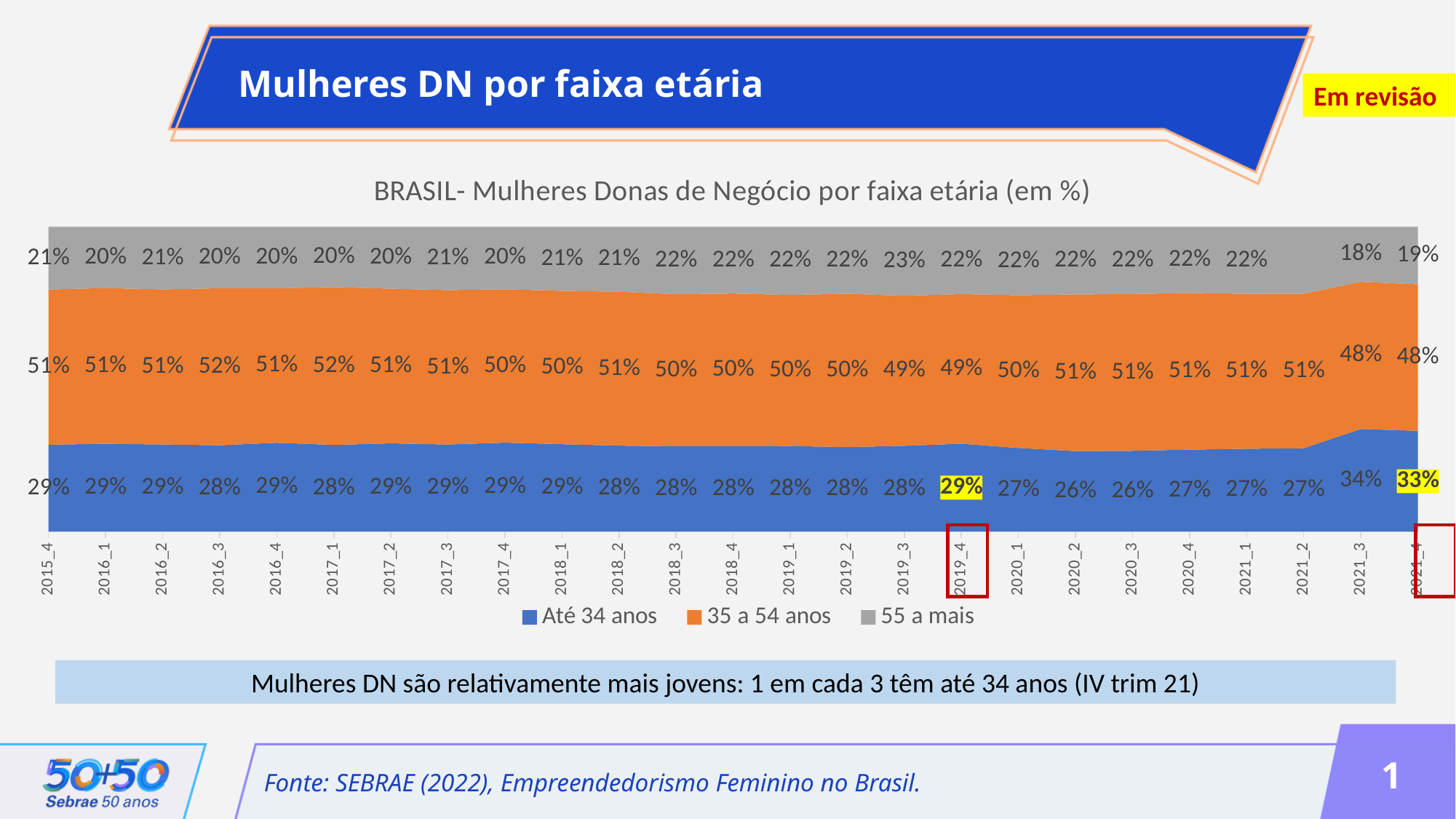
Which colour represents the '35 a 54 anos' series? Orange What is the value for '35 a 54 anos' in 2019_3? 49% Which is larger in 2020_2: the value for 'Até 34 anos' or the value for '55 a mais'? Até 34 anos What is the value for '55 a mais' in 2021_3? 18% What is the value for 'Até 34 anos' in 2021_4? 33% In which period is the value for '55 a mais' highest? 2019_3 How many series does the legend list? 3 In which period is the value for 'Até 34 anos' highest? 2021_3 How many periods are shown on the x axis? 25 What is the title of the chart? BRASIL- Mulheres Donas de Negócio por faixa etária (em %) What is the difference between the 'Até 34 anos' value in 2021_3 and in 2021_2? 7% What type of chart is shown on the slide? Stacked area chart